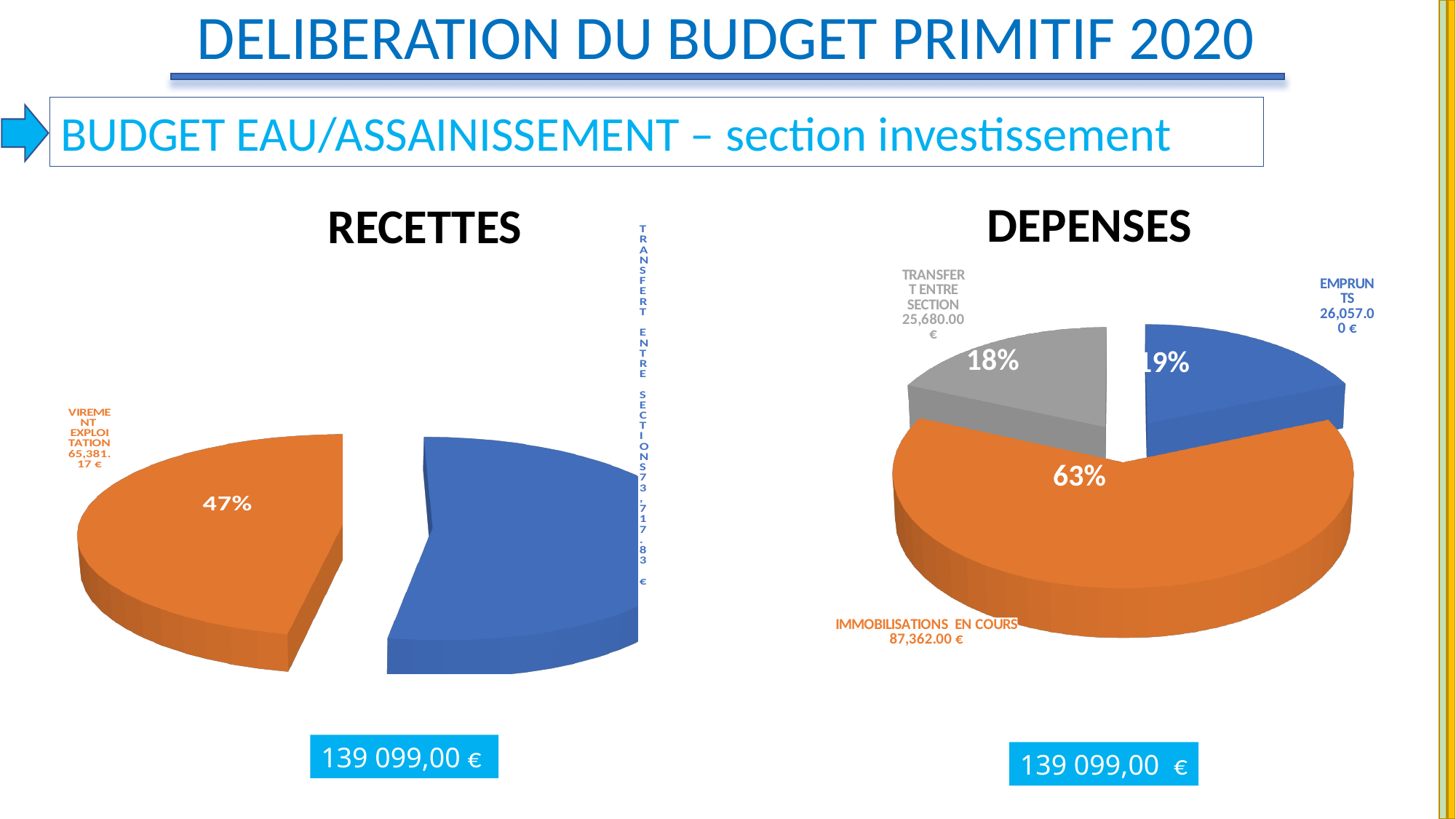
How many slices does the DEPENSES chart have? 3 In the DEPENSES chart, which category has the highest value? IMMOBILISATIONS EN COURS In the DEPENSES chart, what is the difference between IMMOBILISATIONS EN COURS and EMPRUNTS? 61,305.00 € In the DEPENSES chart, which category has the lowest value? TRANSFERT ENTRE SECTION What kind of chart is the RECETTES chart? pie chart In the RECETTES chart, what is the value for VIREMENT EXPLOITATION? 65,381.17 € In the RECETTES chart, what share of the pie is VIREMENT EXPLOITATION? 47% In the RECETTES chart, which is larger, VIREMENT EXPLOITATION or TRANSFERT ENTRE SECTIONS? TRANSFERT ENTRE SECTIONS In the DEPENSES chart, what is the value for EMPRUNTS? 26,057.00 € In the RECETTES chart, what is the value for TRANSFERT ENTRE SECTIONS? 73,717.83 € In the DEPENSES chart, what share of the pie is TRANSFERT ENTRE SECTION? 18% In the DEPENSES chart, what is the value for IMMOBILISATIONS EN COURS? 87,362.00 €